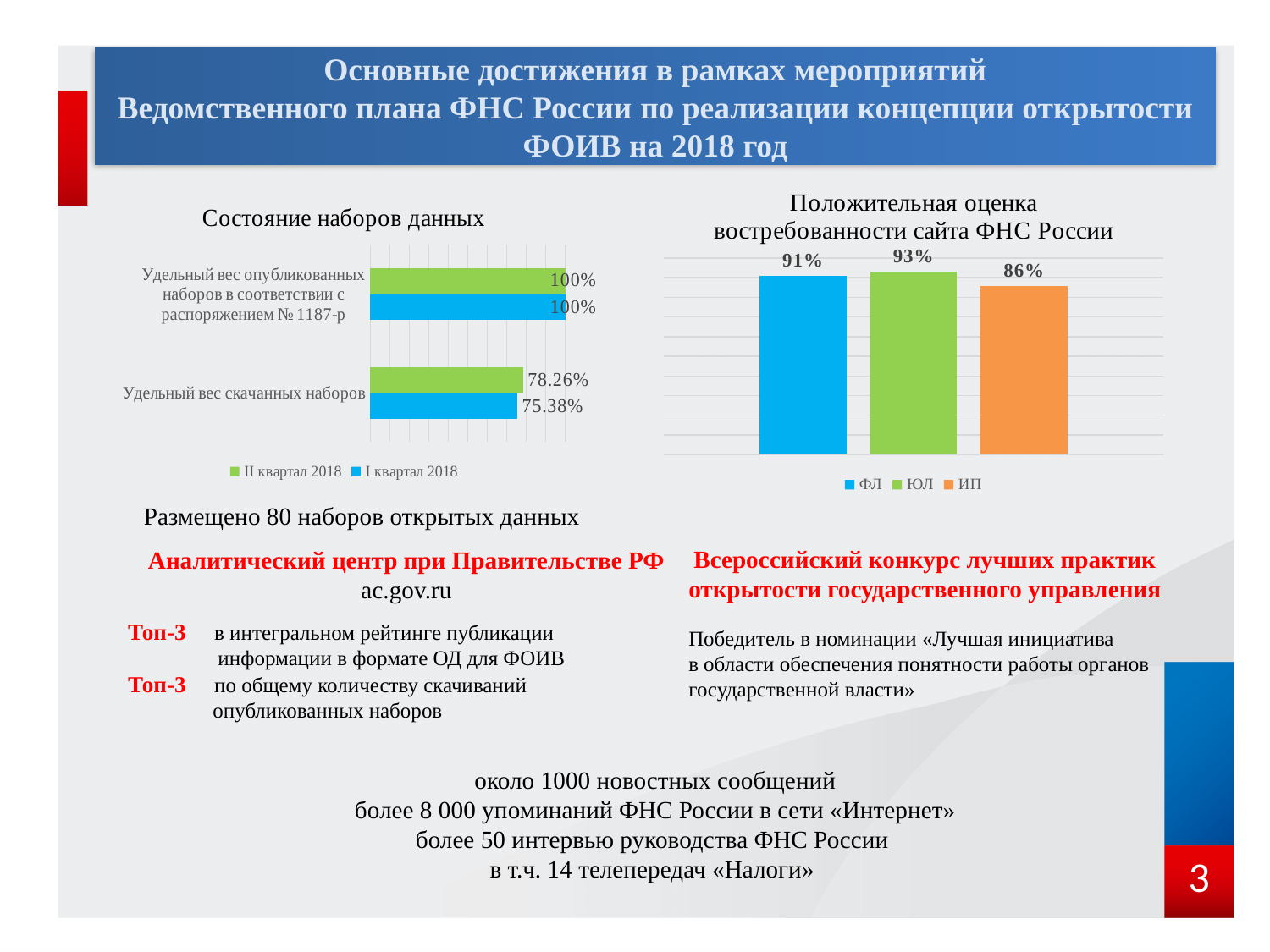
In the chart 'Положительная оценка востребованности сайта ФНС России', what is the value for ИП? 86% In the chart 'Положительная оценка востребованности сайта ФНС России', what is the value for ЮЛ? 93% In the chart 'Положительная оценка востребованности сайта ФНС России', what is the difference between the values for ФЛ and ИП? 5% What kind of chart is 'Состояние наборов данных'? Bar chart In the chart 'Состояние наборов данных', what is the value for 'Удельный вес опубликованных наборов в соответствии с распоряжением № 1187-р' in the 'II квартал 2018' series? 100% In the chart 'Положительная оценка востребованности сайта ФНС России', which category has the lowest value? ИП In the chart 'Положительная оценка востребованности сайта ФНС России', which category has the highest value? ЮЛ In the chart 'Состояние наборов данных', how many series does the legend list? 2 In the chart 'Состояние наборов данных', what is the difference between the 'II квартал 2018' and 'I квартал 2018' values for 'Удельный вес скачанных наборов'? 2.88% In the chart 'Положительная оценка востребованности сайта ФНС России', how many categories are shown? 3 In the chart 'Состояние наборов данных', what is the value for 'Удельный вес скачанных наборов' in the 'II квартал 2018' series? 78.26% In the chart 'Состояние наборов данных', what is the value for 'Удельный вес скачанных наборов' in the 'I квартал 2018' series? 75.38%